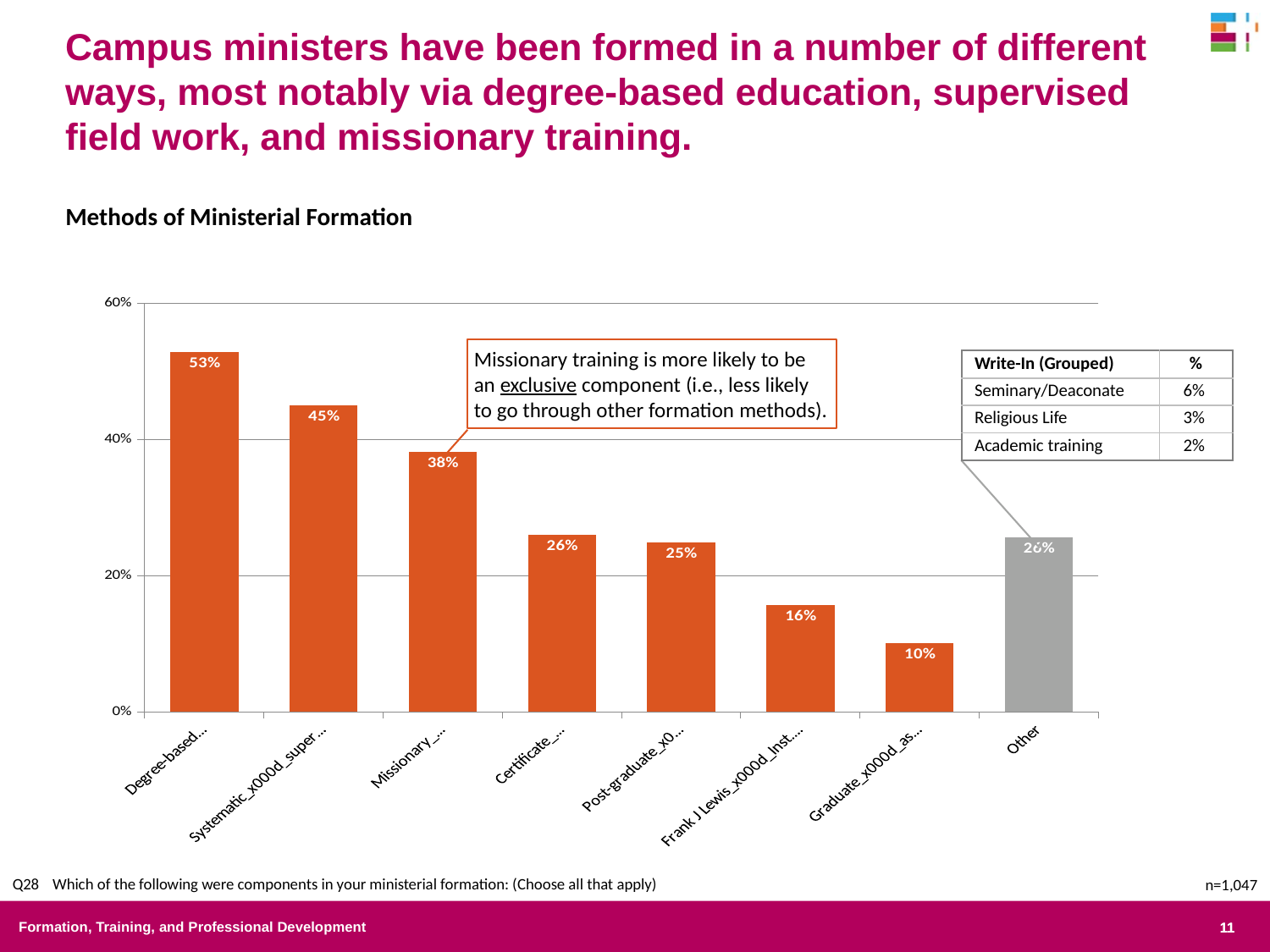
What percentage is shown for Missionary training? 38% What is the difference between the Degree-based value and the Missionary value? 15 percentage points Is the value for the Other bar greater or less than 20%? greater What is the value of the Certificate bar? 26% Which is larger, the Certificate value or the Post-graduate value? Certificate What is the value for the Frank J Lewis bar? 16% How many bars are plotted in the Methods of Ministerial Formation chart? 8 What type of chart is used to show the Methods of Ministerial Formation? Bar chart What value is labelled on the Post-graduate bar? 25% Which formation method has the highest value in the chart? Degree-based Which bar has the lowest value in the chart? Graduate (10%) What is the value for Degree-based in the Methods of Ministerial Formation chart? 53%